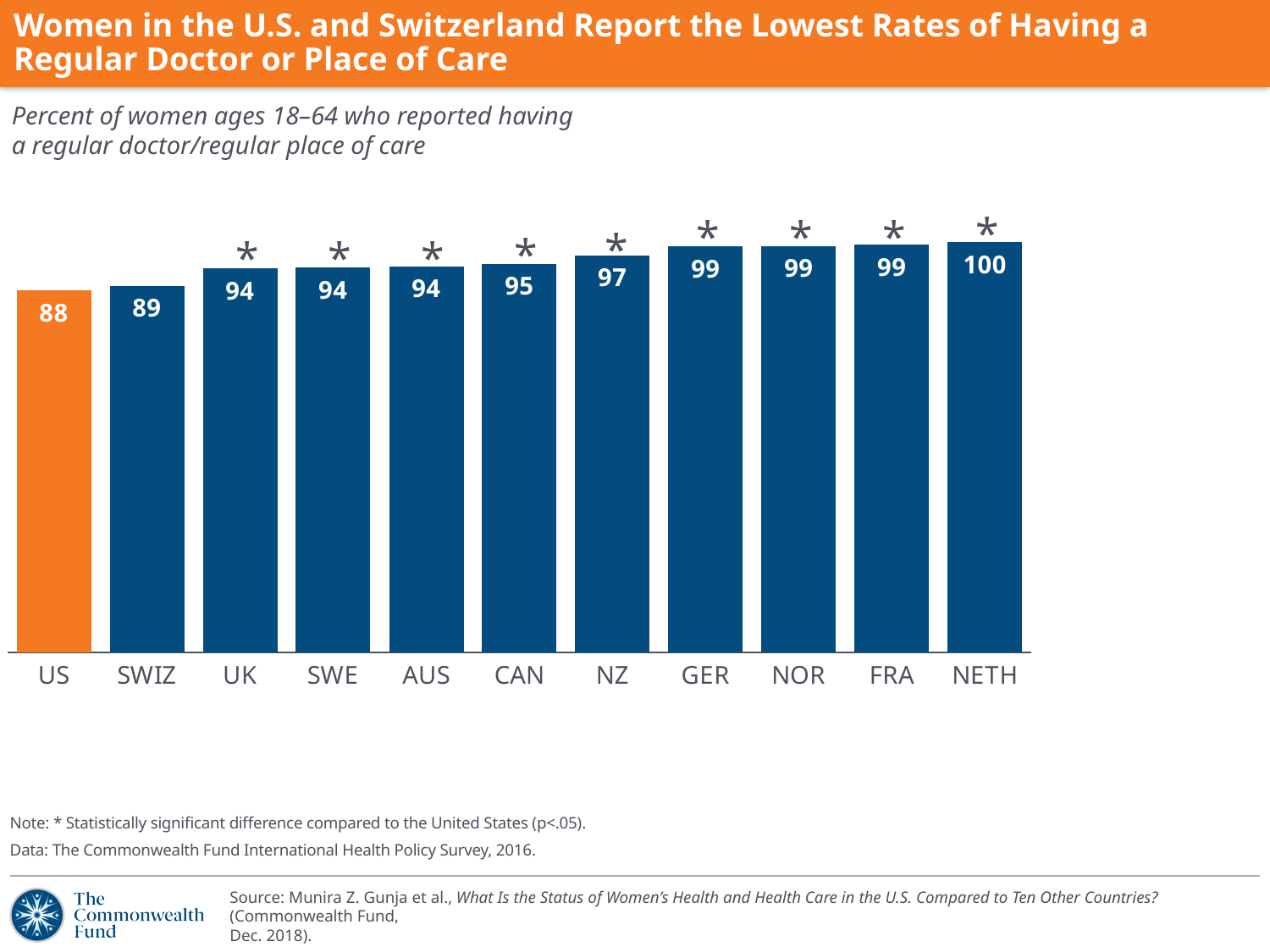
Which country has the lowest value? US What is the difference between the values for UK and SWIZ? 5 Which has a larger value, CAN or SWIZ? CAN What is the value for the US? 88 What is the value for NZ? 97 Which bar is coloured orange rather than blue? US What is the value for SWIZ? 89 What is the difference between the values for NETH and the US? 12 What kind of chart is shown on the slide? Bar chart How many countries are shown on the chart? 11 Which country has the highest value? NETH What is the value for CAN? 95